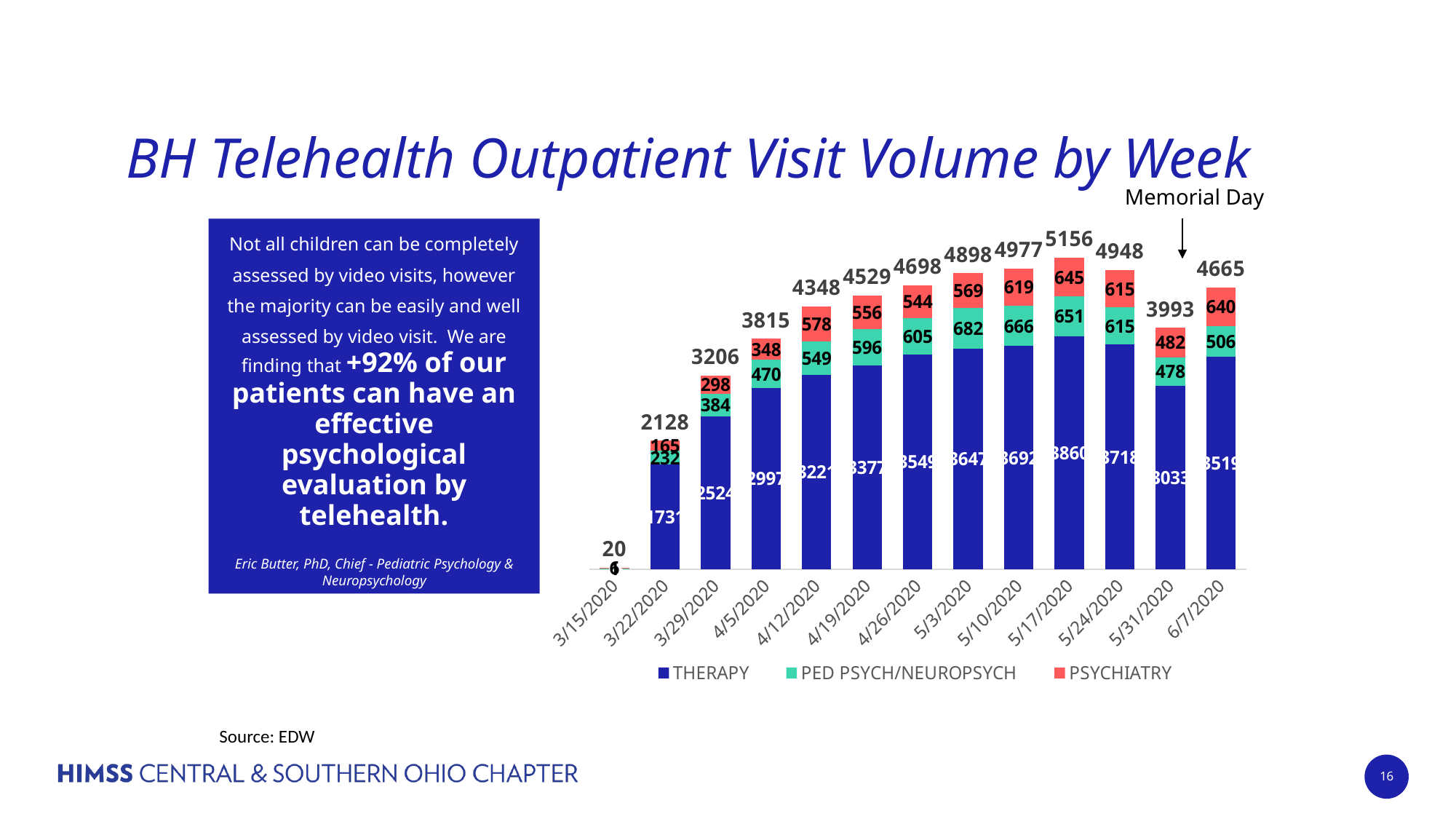
How many weeks are plotted on the x axis? 13 Which is larger, the PSYCHIATRY value for 6/7/2020 or for 5/24/2020? 6/7/2020 How many series does the legend list? 3 What is the PED PSYCH/NEUROPSYCH value for the week of 5/3/2020? 682 What kind of chart is shown on the slide? Stacked bar chart Which week does the Memorial Day annotation arrow point to? 5/31/2020 Which week has the lowest total visit volume? 3/15/2020 What is the total visit volume for the week of 5/17/2020? 5156 What is the difference between the total visit volumes for 5/17/2020 and 5/24/2020? 208 Which week has the highest total visit volume? 5/17/2020 What is the PSYCHIATRY value for the week of 5/17/2020? 645 What is the THERAPY value for the week of 3/22/2020? 1731